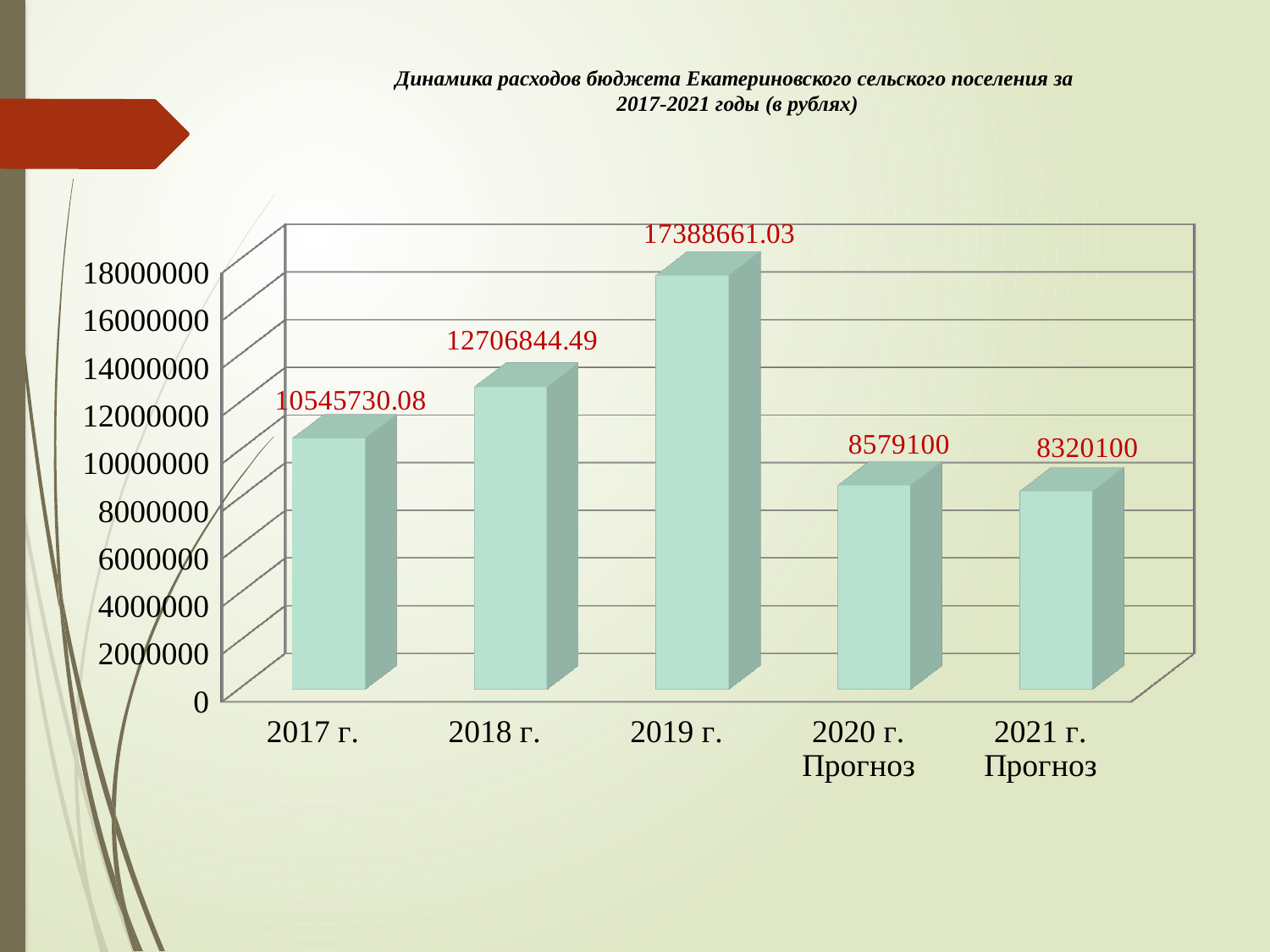
What is the value for 2019 г.? 17388661.03 Which category has the lowest value? 2021 г. Прогноз Do the values rise or fall from 2017 г. to 2019 г.? rise What is the difference between the values for 2019 г. and 2018 г.? 4681816.54 What is the value for 2021 г. Прогноз? 8320100 Which year has the highest value? 2019 г. Is the value for 2020 г. Прогноз greater or less than 10000000? less Which is larger, the value for 2018 г. or the value for 2020 г. Прогноз? 2018 г. How many categories are shown on the x axis? 5 What kind of chart is shown on the slide? bar chart What is the value for 2017 г.? 10545730.08 What is the difference between the values for 2020 г. Прогноз and 2021 г. Прогноз? 259000